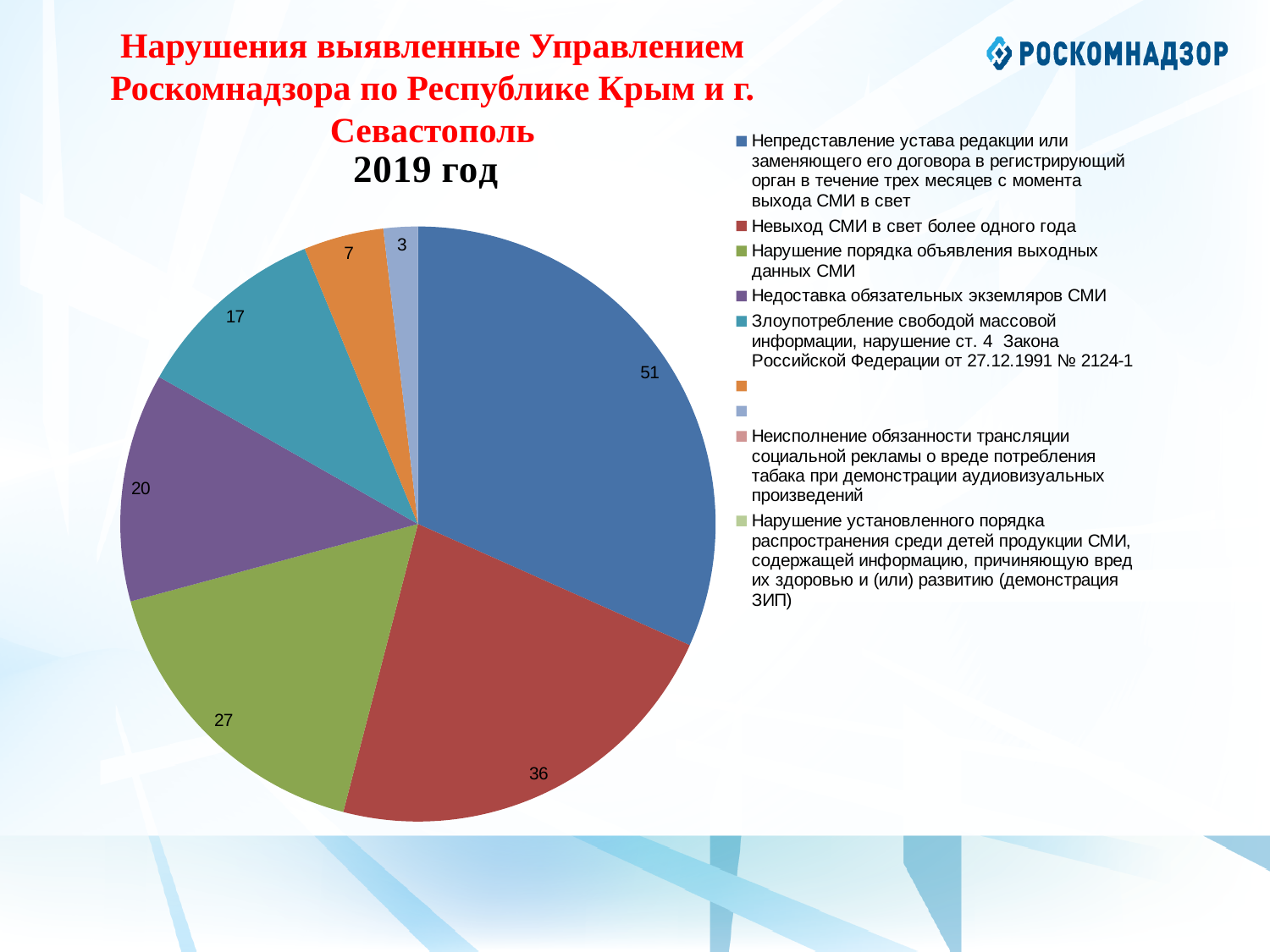
What value is shown for "Недоставка обязательных экземпляров СМИ"? 20 What value is shown for "Нарушение порядка объявления выходных данных СМИ"? 27 What kind of chart is shown on the slide? pie chart Which year does the chart cover, according to the title? 2019 год Which is larger: the slice for "Нарушение порядка объявления выходных данных СМИ" or the slice for "Недоставка обязательных экземпляров СМИ"? Нарушение порядка объявления выходных данных СМИ How many slices with data labels does the pie chart have? 7 What value is shown for "Невыход СМИ в свет более одного года"? 36 Which category has the largest slice of the pie? Непредставление устава редакции или заменяющего его договора в регистрирующий орган в течение трех месяцев с момента выхода СМИ в свет What is the difference between the largest slice (51) and the slice for "Невыход СМИ в свет более одного года"? 15 What value is shown for "Злоупотребление свободой массовой информации, нарушение ст. 4 Закона Российской Федерации от 27.12.1991 № 2124-1"? 17 How many entries does the legend list? 9 What is the smallest value labelled on the pie chart? 3